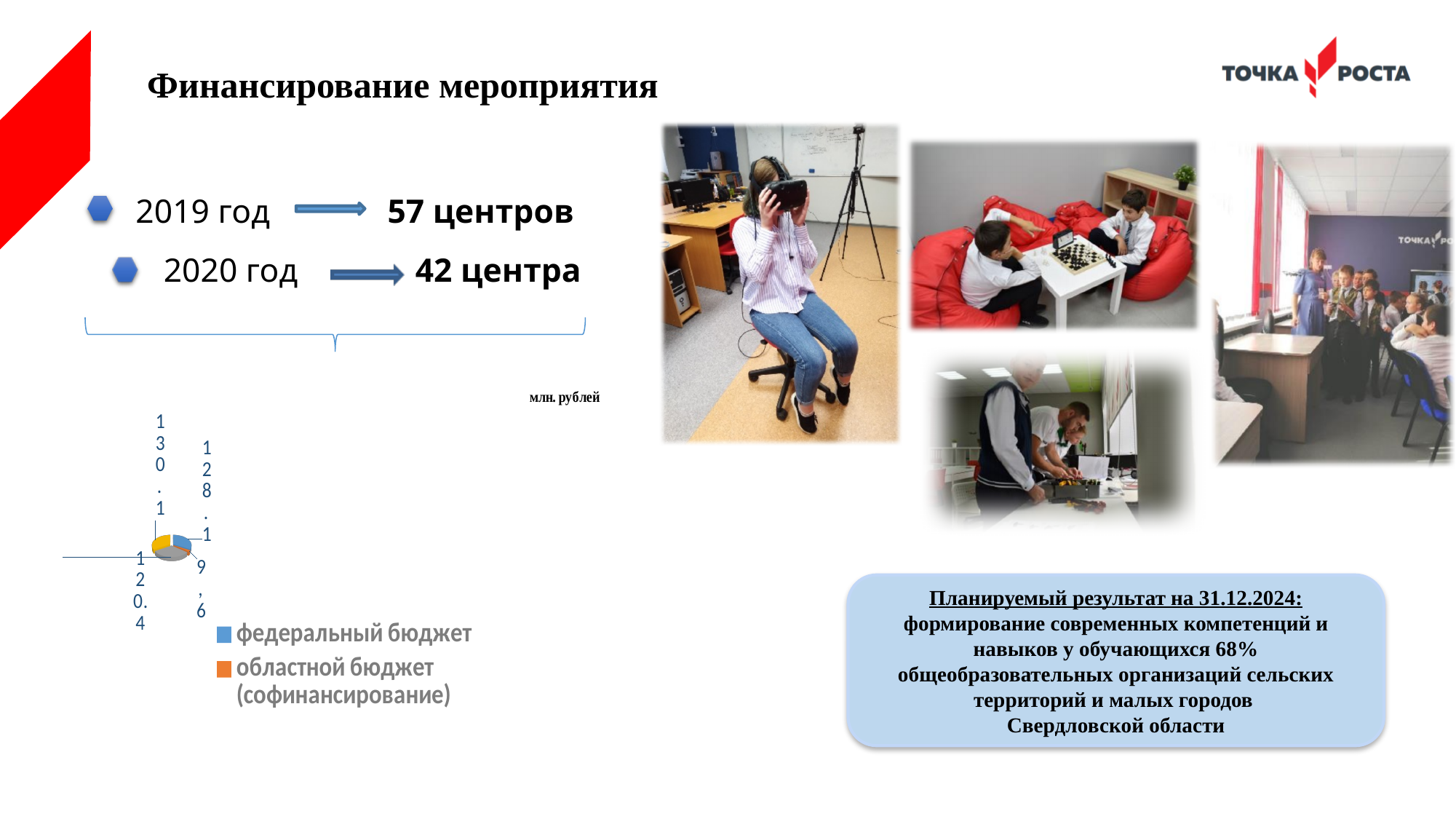
In the pie chart, which slice is larger: the blue one (федеральный бюджет) or the orange one (областной бюджет (софинансирование))? федеральный бюджет How many entries does the legend of the pie chart list? 2 What unit is indicated above the pie chart? млн. рублей What kind of chart is shown on the slide? pie chart Which legend entry of the pie chart is shown in blue? федеральный бюджет